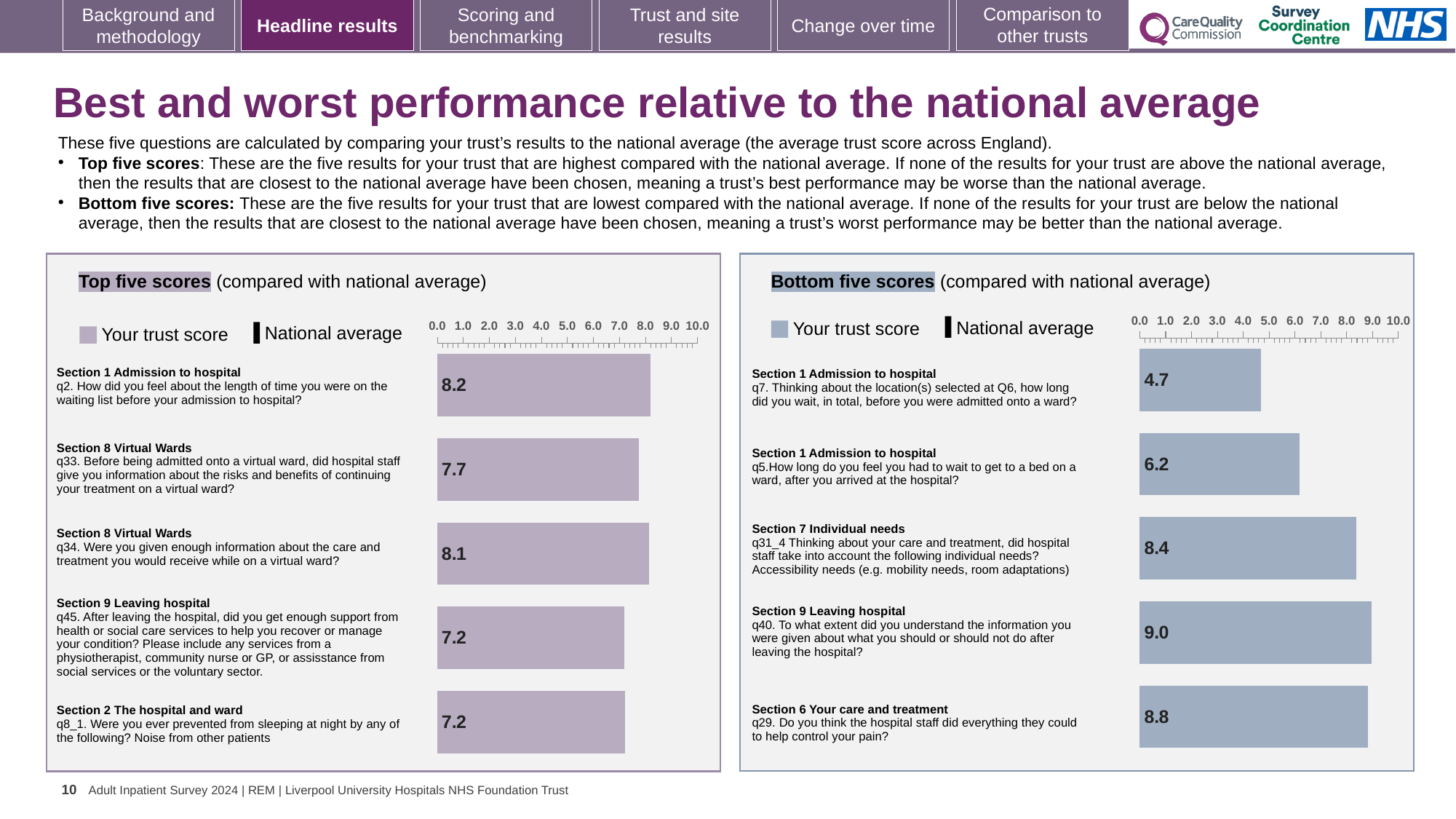
In the Bottom five scores chart, what is the trust score for q31_4 (accessibility needs taken into account)? 8.4 In the Top five scores chart, what is the trust score for q2 (length of time on the waiting list before admission)? 8.2 In the Top five scores chart, is the trust score for q33 greater or less than 7.0? greater In the Bottom five scores chart, what is the trust score for q7 (how long did you wait before being admitted onto a ward)? 4.7 In the Top five scores chart, which question has the highest trust score? q2 (8.2) In the Bottom five scores chart, which question has the highest trust score? q40 (9.0) In the Bottom five scores chart, which question has the lowest trust score? q7 (4.7) What type of chart is used in the Top five scores panel? Bar chart How many questions are shown as bars in the Top five scores chart? 5 How many series does the legend of the Bottom five scores chart list? 2 In the Top five scores chart, what is the difference between the trust scores for q2 and q45? 1.0 In the Bottom five scores chart, which has the larger trust score, q40 or q29? q40